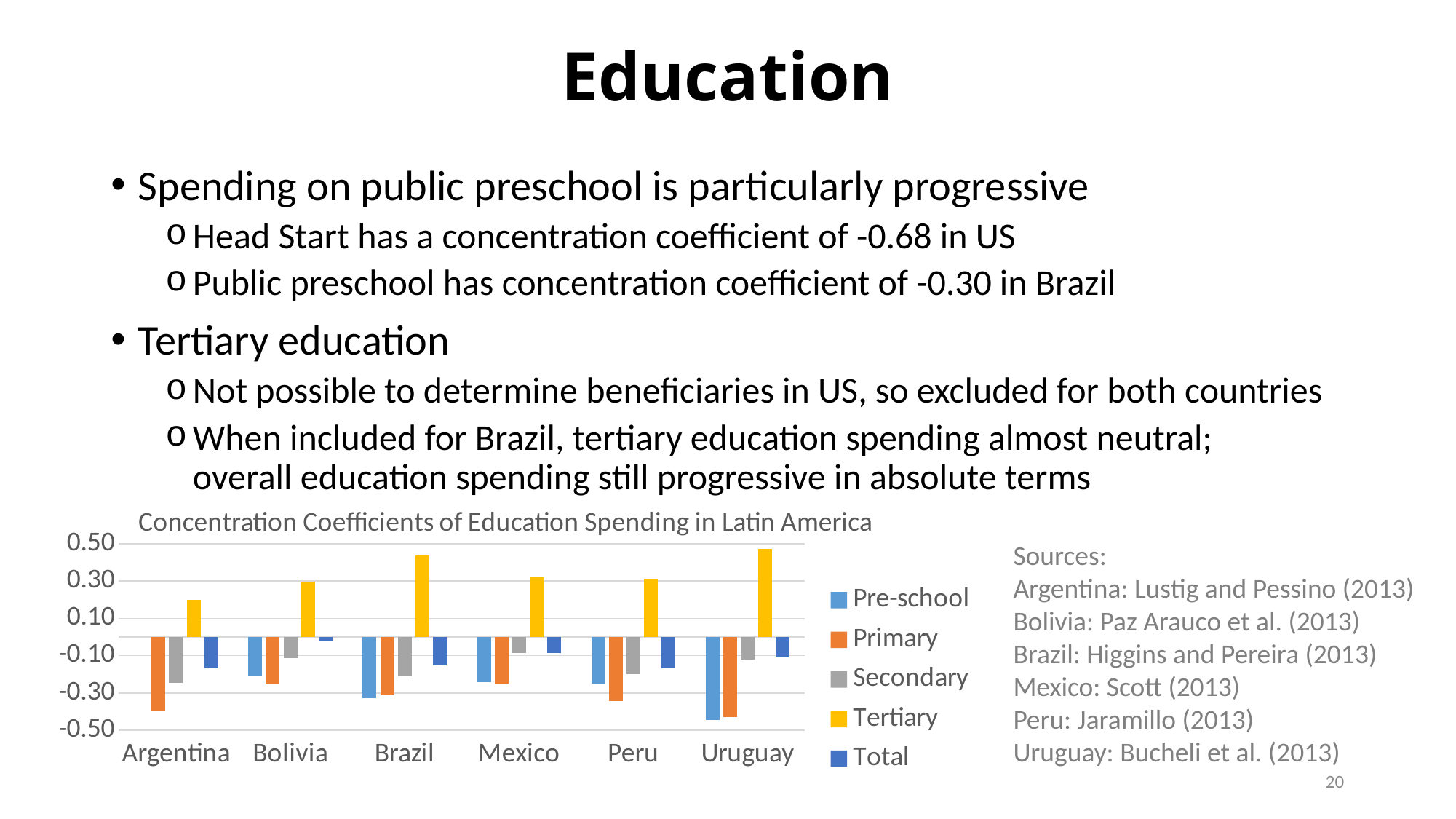
Is the Tertiary value for Brazil greater or less than 0.30? greater Is the Primary value for Argentina greater or less than -0.30? less Which country has the lowest Pre-school concentration coefficient? Uruguay How many countries are shown on the x axis of the chart? 6 Is the Tertiary value for Uruguay greater or less than 0.30? greater Which colour represents the Tertiary series in the chart? yellow How many series does the chart legend list? 5 What kind of chart is shown on the slide? bar chart Which is larger, the Pre-school value for Bolivia or the Pre-school value for Brazil? Bolivia Which country has the lowest Primary concentration coefficient? Uruguay What is the title of the chart? Concentration Coefficients of Education Spending in Latin America